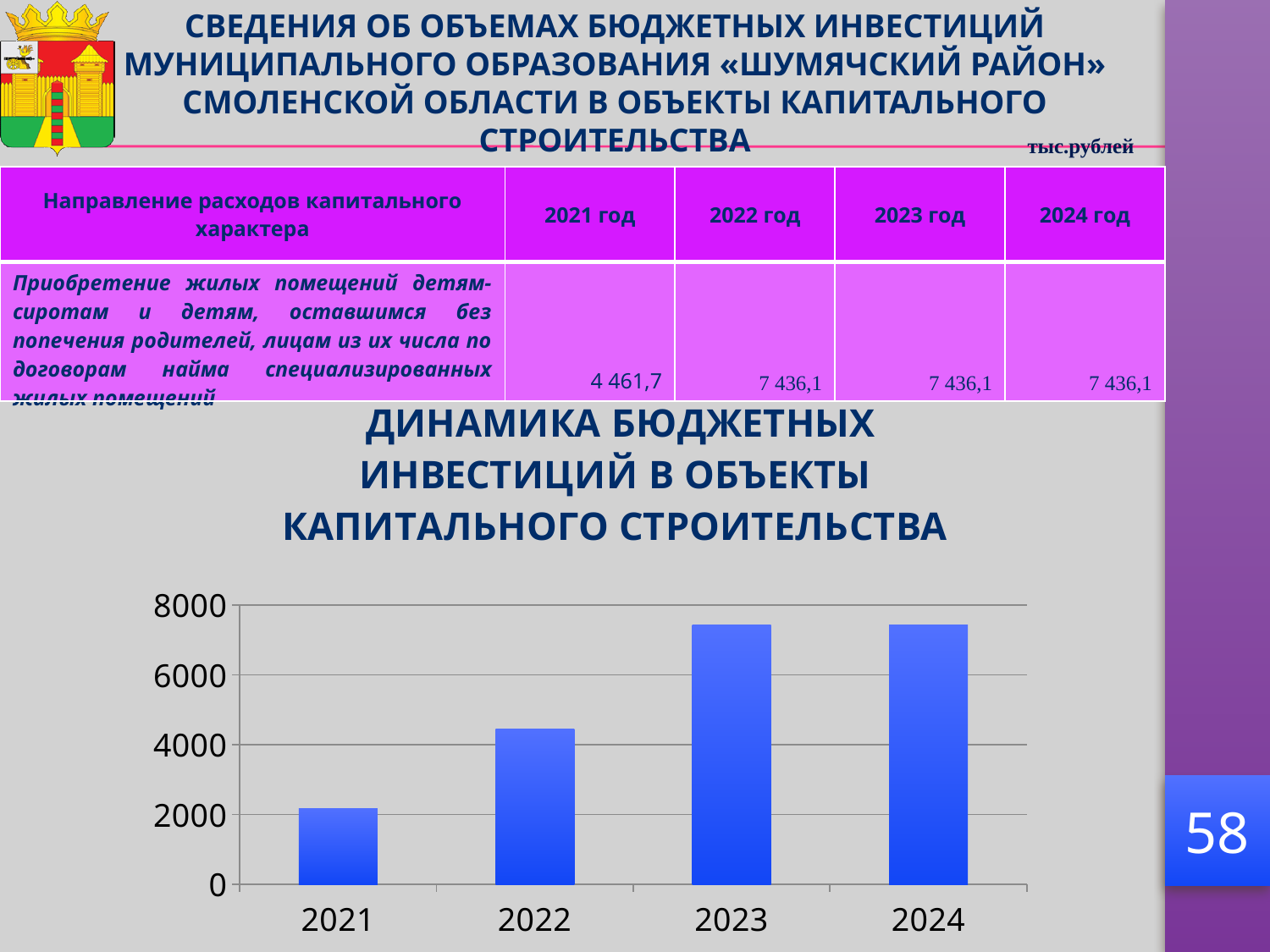
What is the highest value shown on the vertical axis of the chart? 8000 Do the bar values rise or fall from 2021 to 2023 in the chart? rise Is the value for 2021 in the chart greater or less than 4000? less Is the value for 2023 in the chart greater or less than 6000? greater Is the value for 2024 in the chart greater or less than 8000? less Which bar is taller in the chart, 2021 or 2022? 2022 Which year has the lowest bar in the chart? 2021 How many years are shown on the x axis of the chart? 4 Which bar is taller in the chart, 2022 or 2023? 2023 What kind of chart is shown on the slide? bar chart